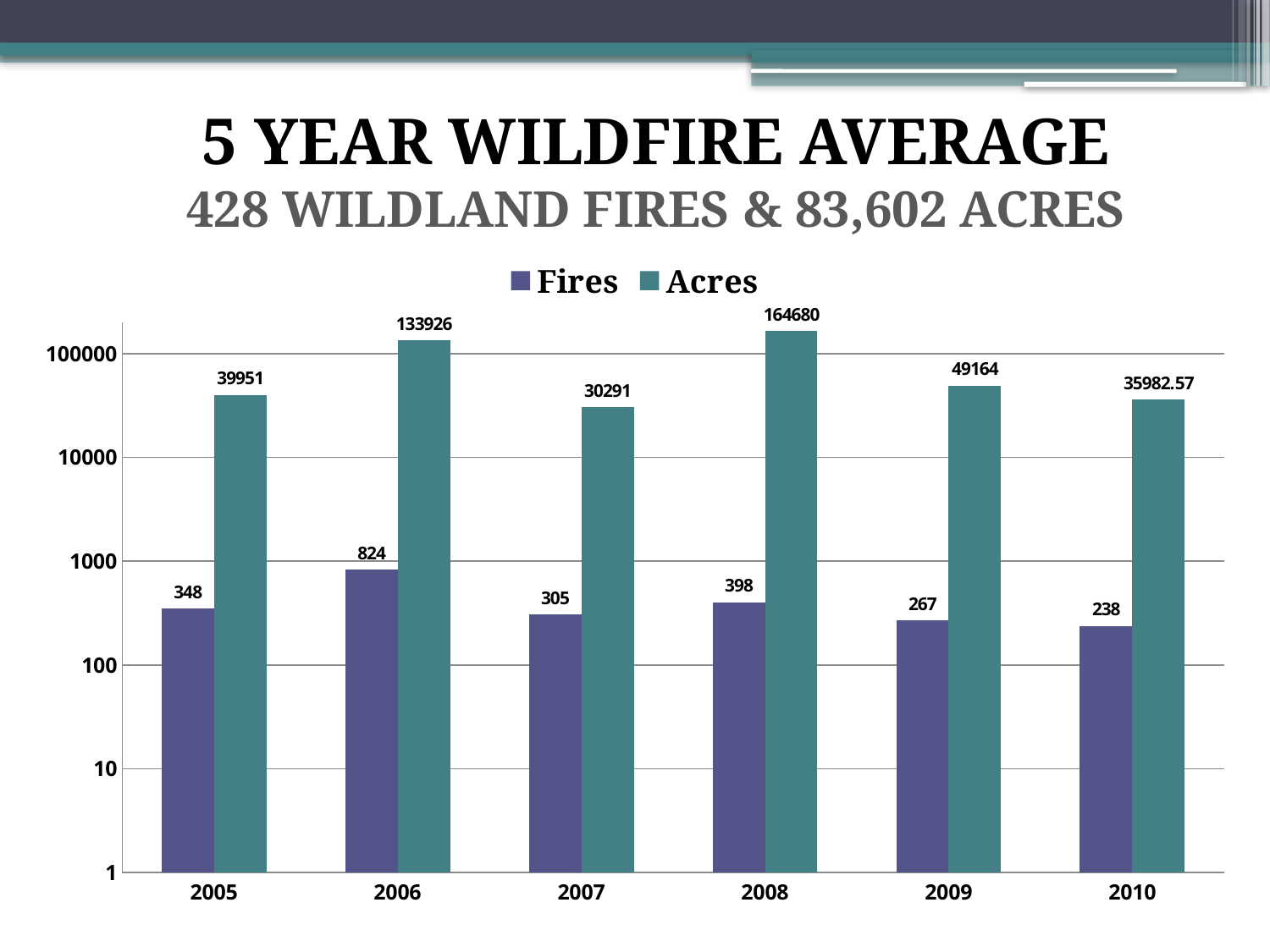
Which year has the highest number of fires? 2006 Is the Fires value for 2008 greater or less than 1000? less How many fires were recorded in 2006? 824 Which year has the lowest Acres value? 2007 What kind of chart is shown on the slide? bar chart How many years are shown on the x axis? 6 Which year had more acres burned, 2006 or 2009? 2006 What is the difference in fires between 2005 and 2007? 43 How many acres burned in 2008? 164680 How many series does the legend list? 2 What is the Acres value for 2010? 35982.57 Which year has the lowest number of fires? 2010